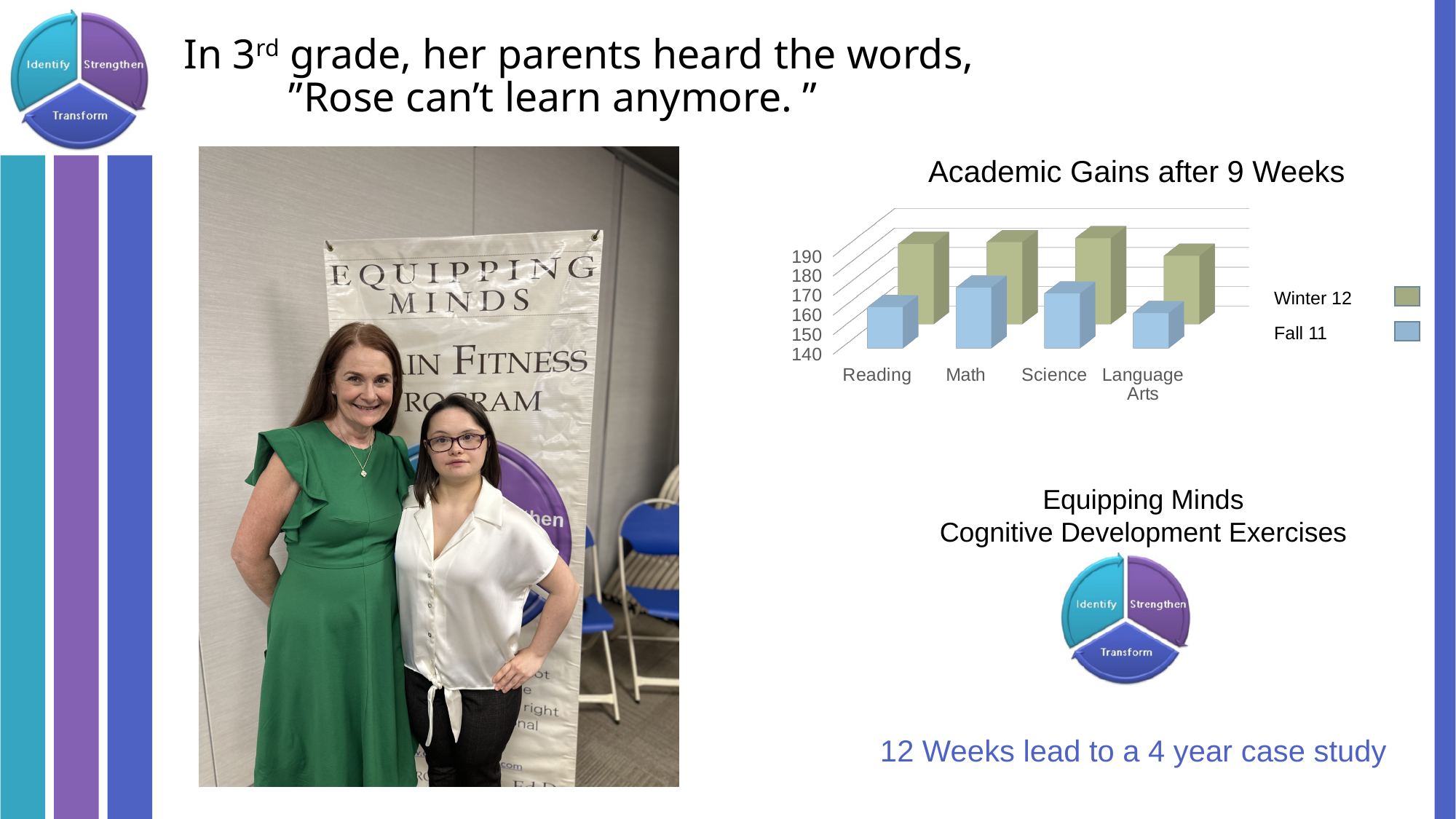
What is the title of the chart? Academic Gains after 9 Weeks Which series is shown in green in the chart? Winter 12 What type of chart is shown on the slide? Bar chart Is the Winter 12 value for Science greater or less than 170? greater How many categories are shown on the x axis of the chart? 4 Which category has the lowest Fall 11 value? Language Arts How many series does the chart's legend list? 2 Is the Fall 11 value for Reading greater or less than 190? less For Language Arts, which series has the larger value, Fall 11 or Winter 12? Winter 12 Is the Fall 11 value for Language Arts greater or less than 180? less Which category has the lowest Winter 12 value? Language Arts For Reading, which series has the larger value, Winter 12 or Fall 11? Winter 12